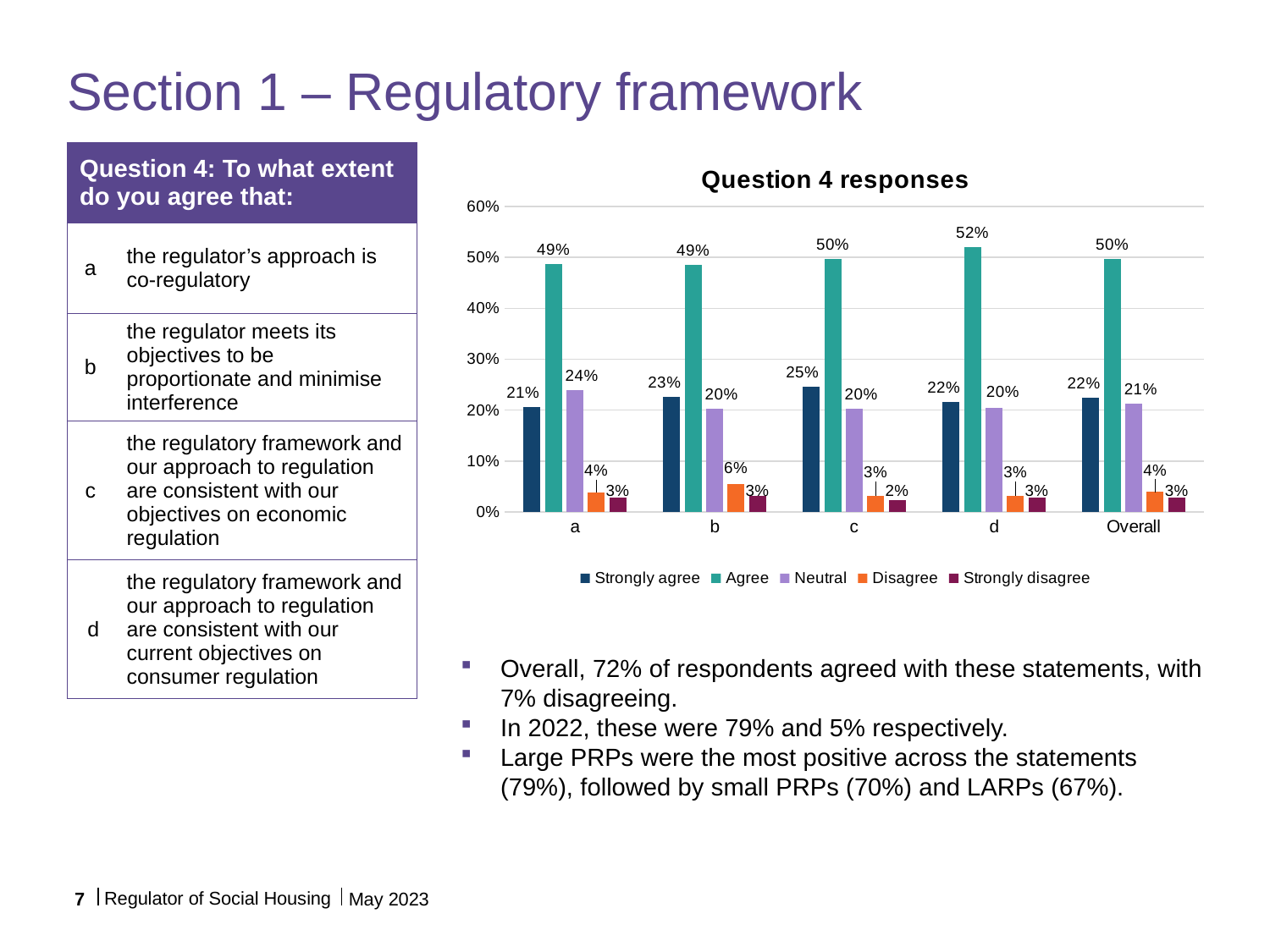
How many categories are shown on the x axis? 5 How many series does the legend list? 5 What is the value for Strongly agree in category c? 25% Which is larger in category b: Strongly agree or Neutral? Strongly agree What is the value for Agree in category d? 52% What is the value for Disagree in category b? 6% What kind of chart is shown? Bar chart Which category has the lowest Strongly disagree value? c Which category has the highest Agree value? d What is the value for Neutral in category a? 24% What is the title of the chart? Question 4 responses What is the difference between the Agree and Strongly agree values in the Overall category? 28%